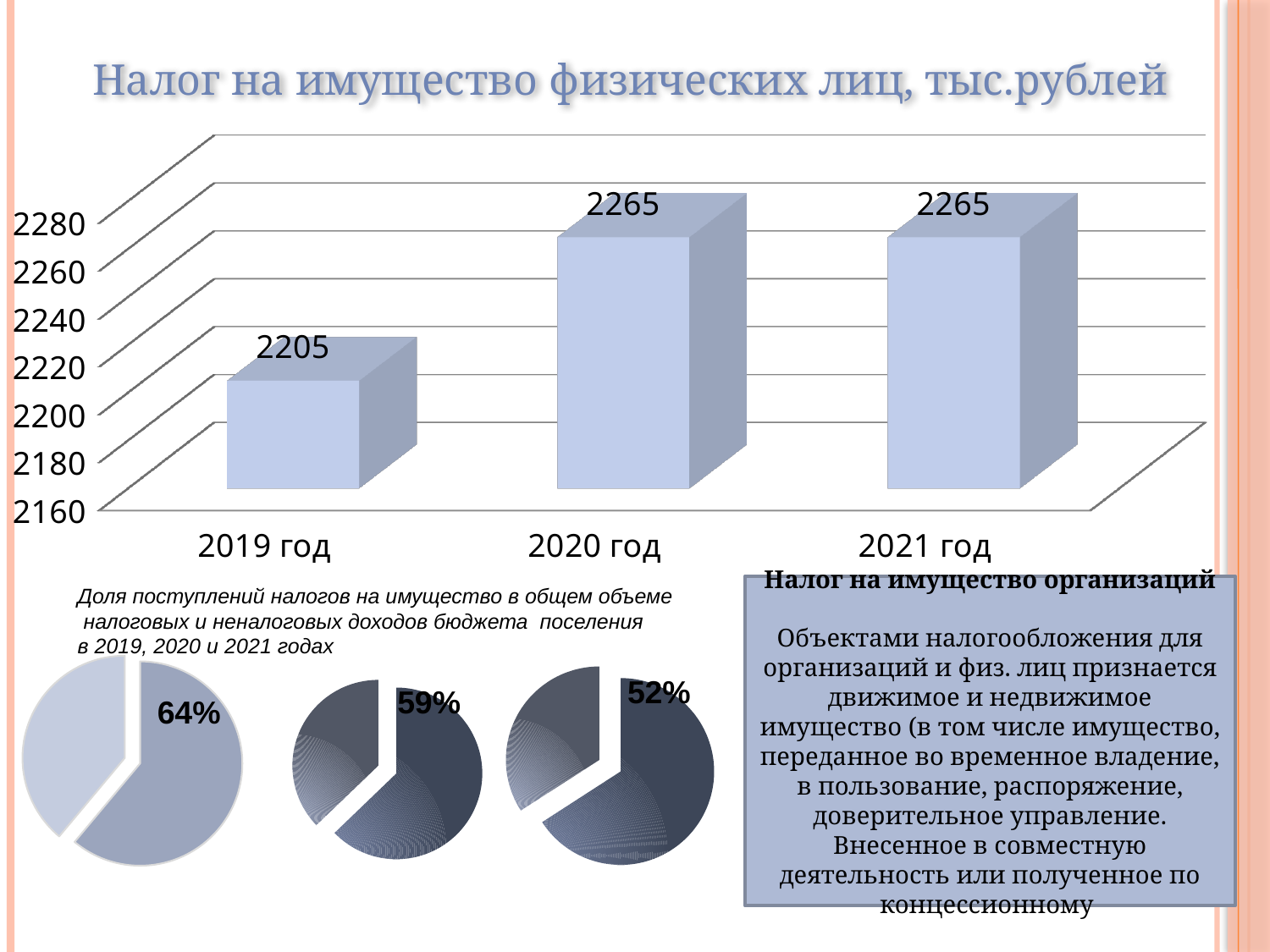
On the bar chart 'Налог на имущество физических лиц, тыс.рублей', what is the difference between the values for 2020 год and 2019 год? 60 On the bar chart 'Налог на имущество физических лиц, тыс.рублей', what is the value for 2021 год? 2265 On the leftmost pie chart at the bottom of the slide (2019), what share is labelled on the highlighted slice? 64% On the bar chart 'Налог на имущество физических лиц, тыс.рублей', what is the value for 2019 год? 2205 On the bar chart 'Налог на имущество физических лиц, тыс.рублей', do the values rise or fall from 2019 год to 2020 год? rise What kind of chart is the top chart titled 'Налог на имущество физических лиц, тыс.рублей'? bar chart On the bar chart 'Налог на имущество физических лиц, тыс.рублей', which year has the lowest value? 2019 год On the bar chart 'Налог на имущество физических лиц, тыс.рублей', is the value for 2019 год greater or less than 2220? less On the bar chart 'Налог на имущество физических лиц, тыс.рублей', which is larger, the value for 2019 год or the value for 2021 год? 2021 год On the rightmost pie chart at the bottom of the slide (2021), what share is labelled on the highlighted slice? 52% On the bar chart 'Налог на имущество физических лиц, тыс.рублей', what is the value for 2020 год? 2265 On the bar chart 'Налог на имущество физических лиц, тыс.рублей', how many years are plotted? 3